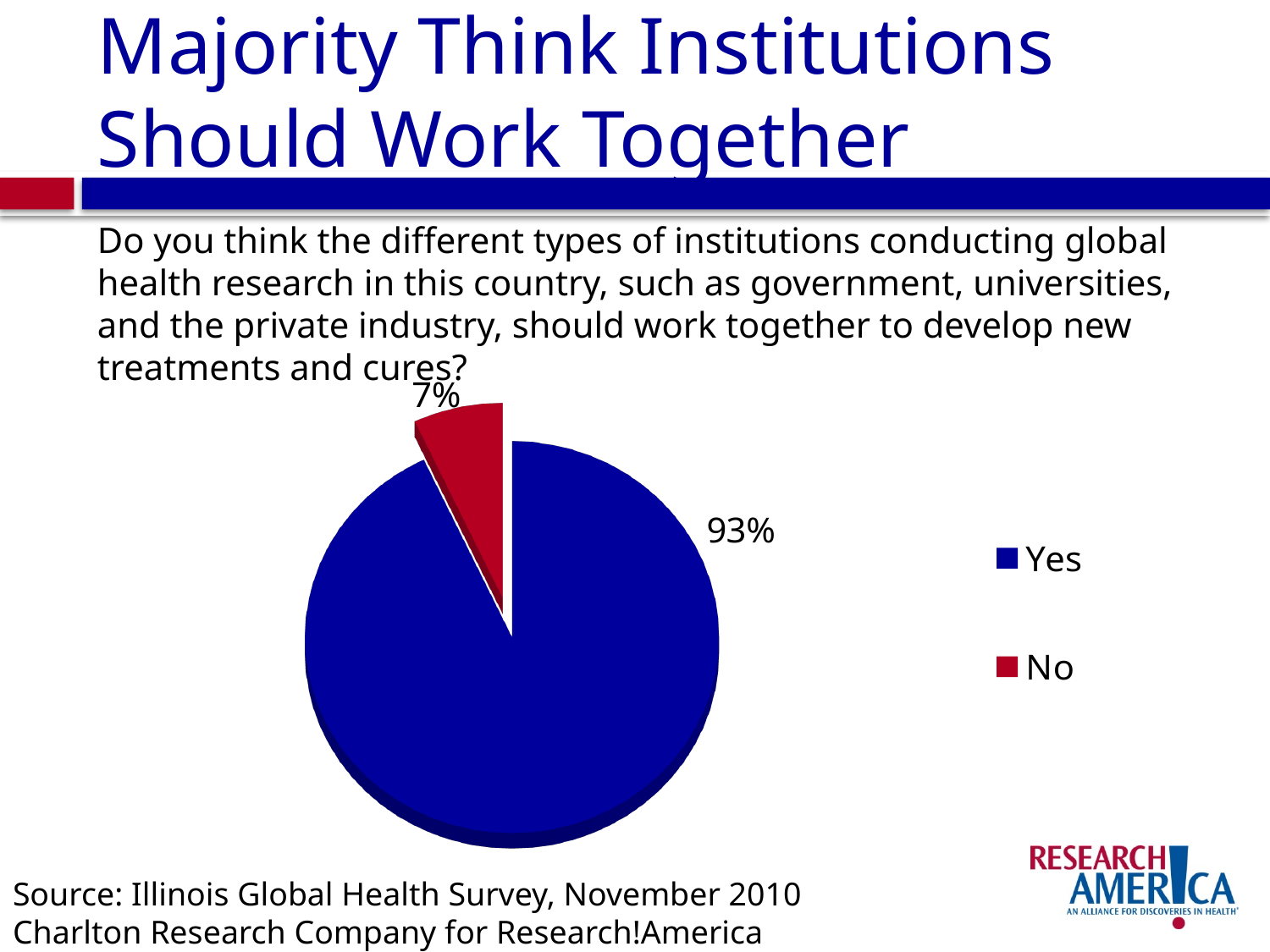
Which response has the smallest share of the pie? No Which response has the largest share of the pie? Yes What share of the pie does the No slice represent? 7% What colour is the No slice of the pie? Red Which is larger, the share for Yes or the share for No? Yes How many entries does the legend list? 2 What percentage of respondents answered No? 7% What kind of chart is shown on the slide? Pie chart What is the difference in percentage points between the Yes and No shares? 86 How many slices does the pie chart have? 2 What percentage of respondents answered Yes? 93% What colour is the Yes slice of the pie? Blue